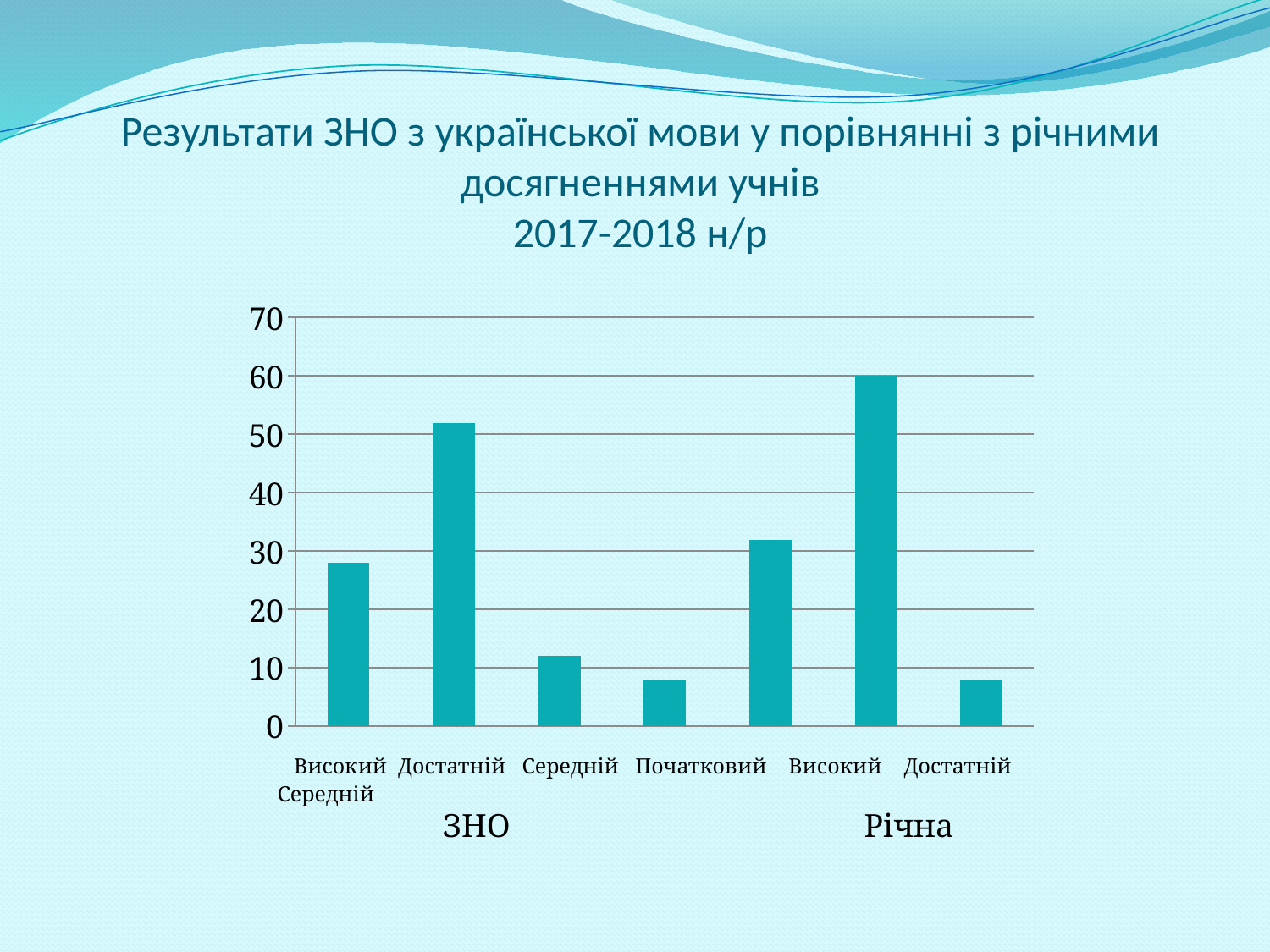
Is the value for Високий in the ЗНО group greater or less than 30? less Is the value for Високий in the Річна group greater or less than 20? greater Which is larger: Достатній in the ЗНО group or Достатній in the Річна group? Достатній in the Річна group What are the two groups labelled along the x axis of the chart? ЗНО and Річна What kind of chart is shown on the slide? bar chart Which is larger: Високий in the ЗНО group or Високий in the Річна group? Високий in the Річна group How many bars are plotted in the chart? 7 Is the value for Початковий in the ЗНО group greater or less than 10? less Which bar is the highest in the chart? Достатній (Річна)